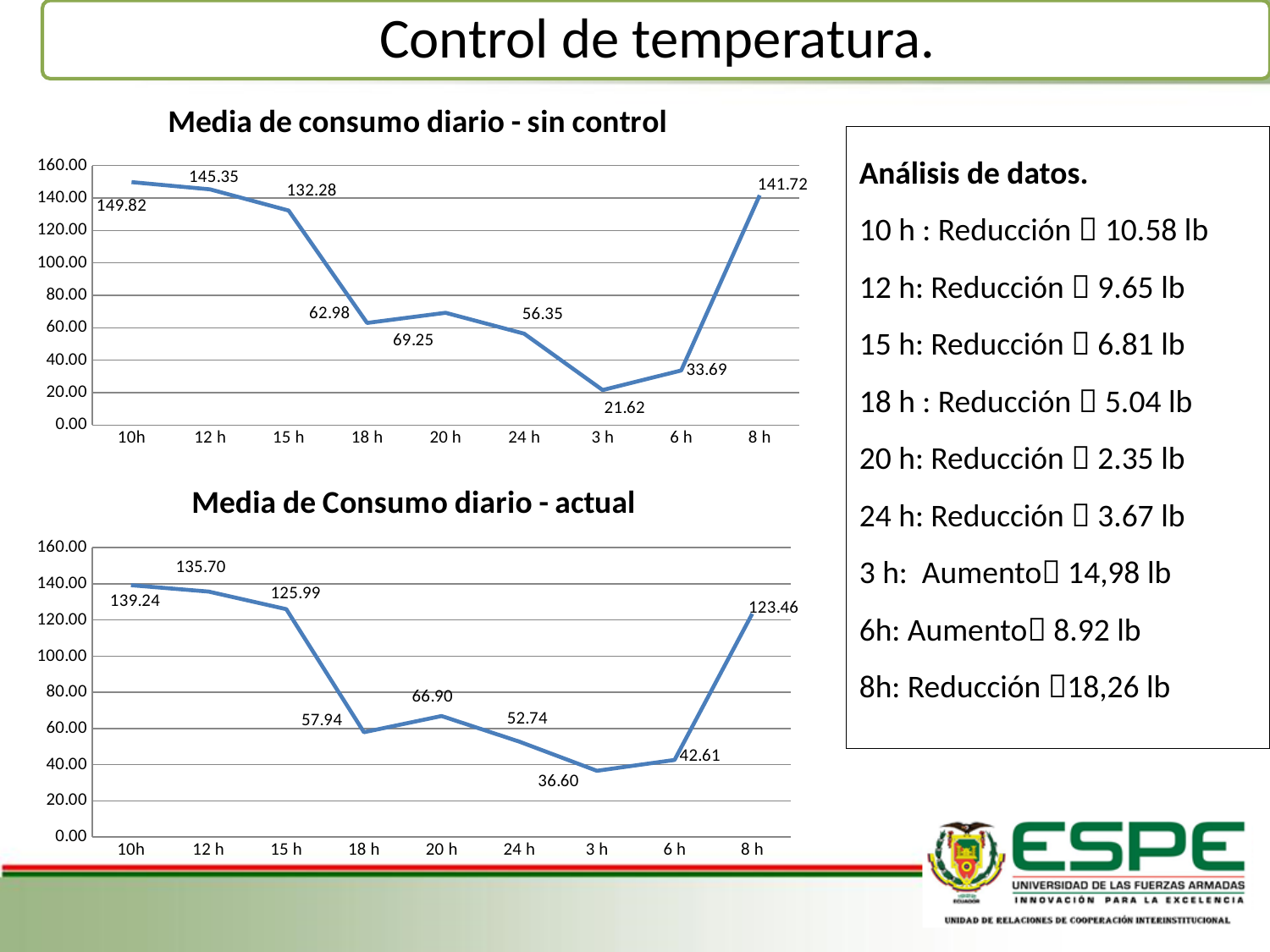
In the chart 'Media de consumo diario - sin control', what is the difference between the values at 12 h and 15 h? 13.07 In the chart 'Media de Consumo diario - actual', how many time points are plotted? 9 In the chart 'Media de Consumo diario - actual', what is the value at 20 h? 66.90 In the chart 'Media de consumo diario - sin control', which time has the lowest value? 3 h In the chart 'Media de consumo diario - sin control', what is the value at 3 h? 21.62 In the chart 'Media de Consumo diario - actual', do the values rise or fall from 10h to 15 h? Fall What type of chart is 'Media de consumo diario - sin control'? Line chart In the chart 'Media de Consumo diario - actual', which is larger, the value at 18 h or the value at 20 h? 20 h In the chart 'Media de consumo diario - sin control', what is the value at 10h? 149.82 In the chart 'Media de consumo diario - sin control', which time has the highest value? 10h In the chart 'Media de Consumo diario - actual', which time has the lowest value? 3 h In the chart 'Media de Consumo diario - actual', what is the value at 8 h? 123.46